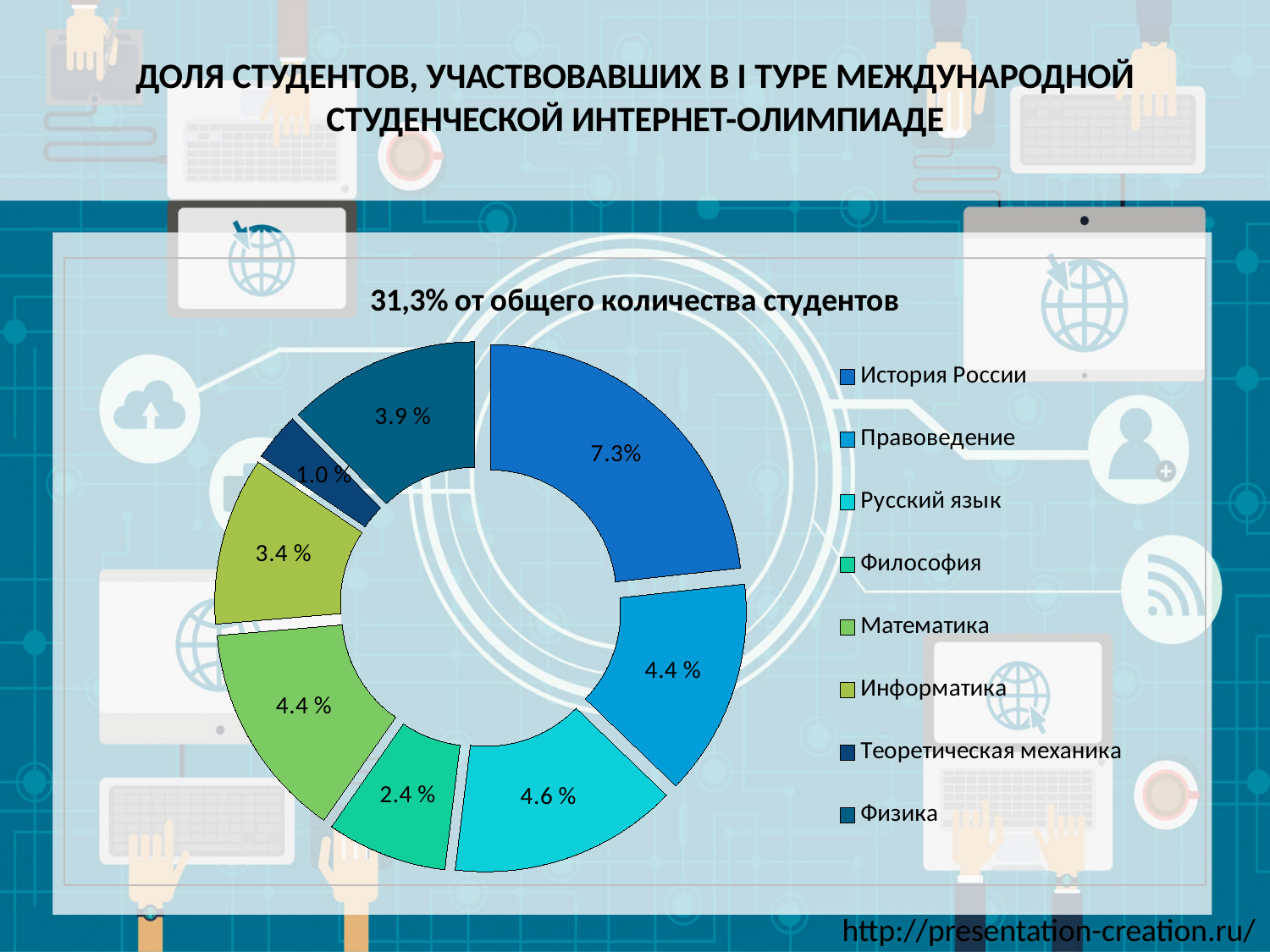
What is the difference between the values for Русский язык and Философия? 2.2 % How many categories does the chart show? 8 What value is shown for Теоретическая механика? 1.0 % What value is shown for Информатика? 3.4 % What kind of chart is shown on the slide? Doughnut chart Which category has the smallest share in the chart? Теоретическая механика What is the title shown above the chart? 31,3% от общего количества студентов Which category has the largest share in the chart? История России What is the difference between the values for История России and Правоведение? 2.9% What value is shown for История России in the doughnut chart? 7.3% What value is shown for Физика? 3.9 % Which is larger, the value for Русский язык or the value for Правоведение? Русский язык